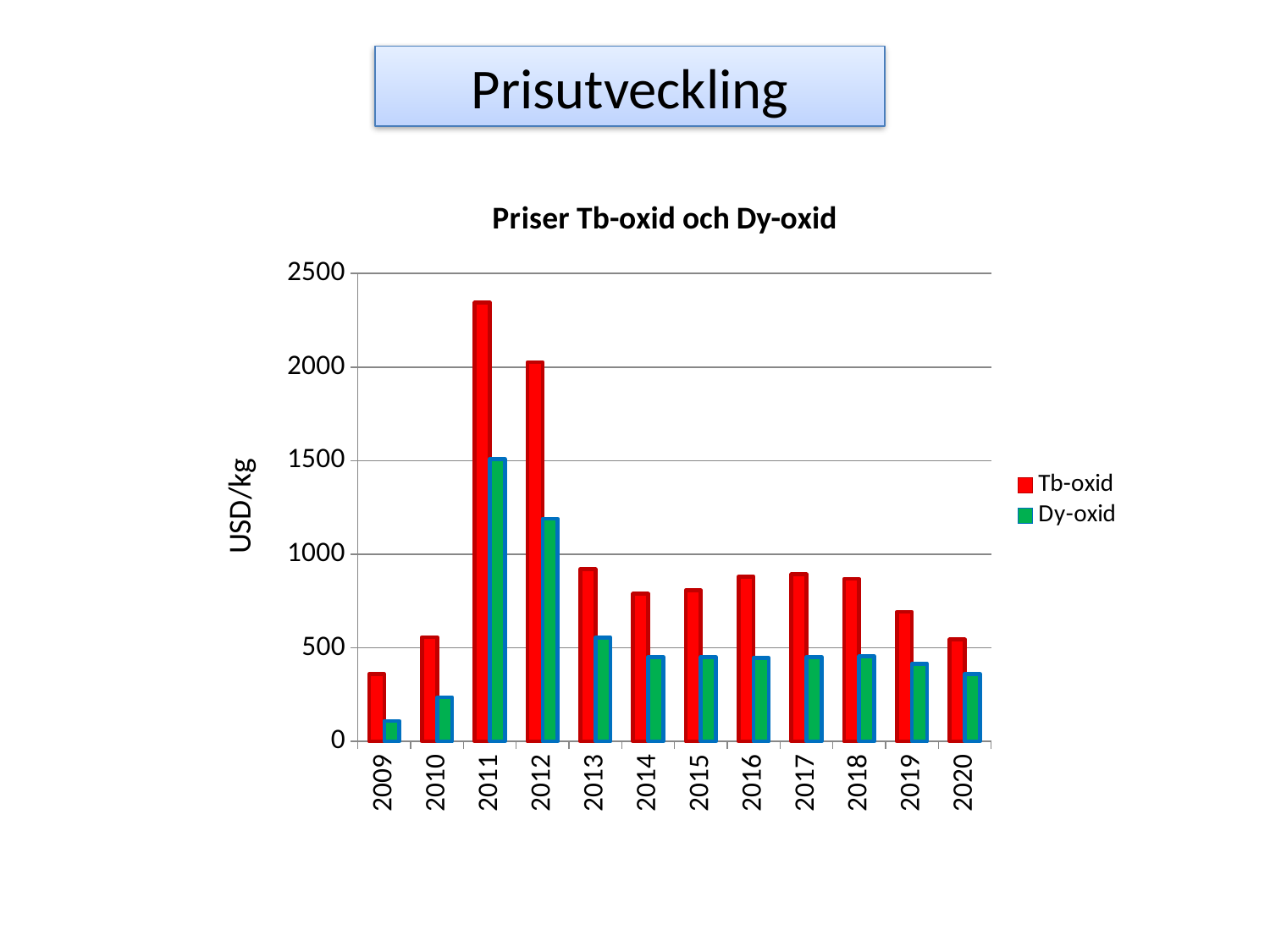
How many years are shown on the x axis? 12 What kind of chart is shown on the slide? Bar chart What is the label on the y axis? USD/kg Is the value for Tb-oxid in 2011 greater or less than 2000? greater Is the value for Tb-oxid in 2013 greater or less than 1000? less Does the Tb-oxid price rise or fall from 2017 to 2020? Fall In which year is the Dy-oxid price lowest? 2009 How many series does the legend list? 2 In which year is the Tb-oxid price highest? 2011 In which year is the Dy-oxid price highest? 2011 Which is larger in 2013, the Tb-oxid price or the Dy-oxid price? Tb-oxid Is the value for Dy-oxid in 2012 greater or less than 1000? greater